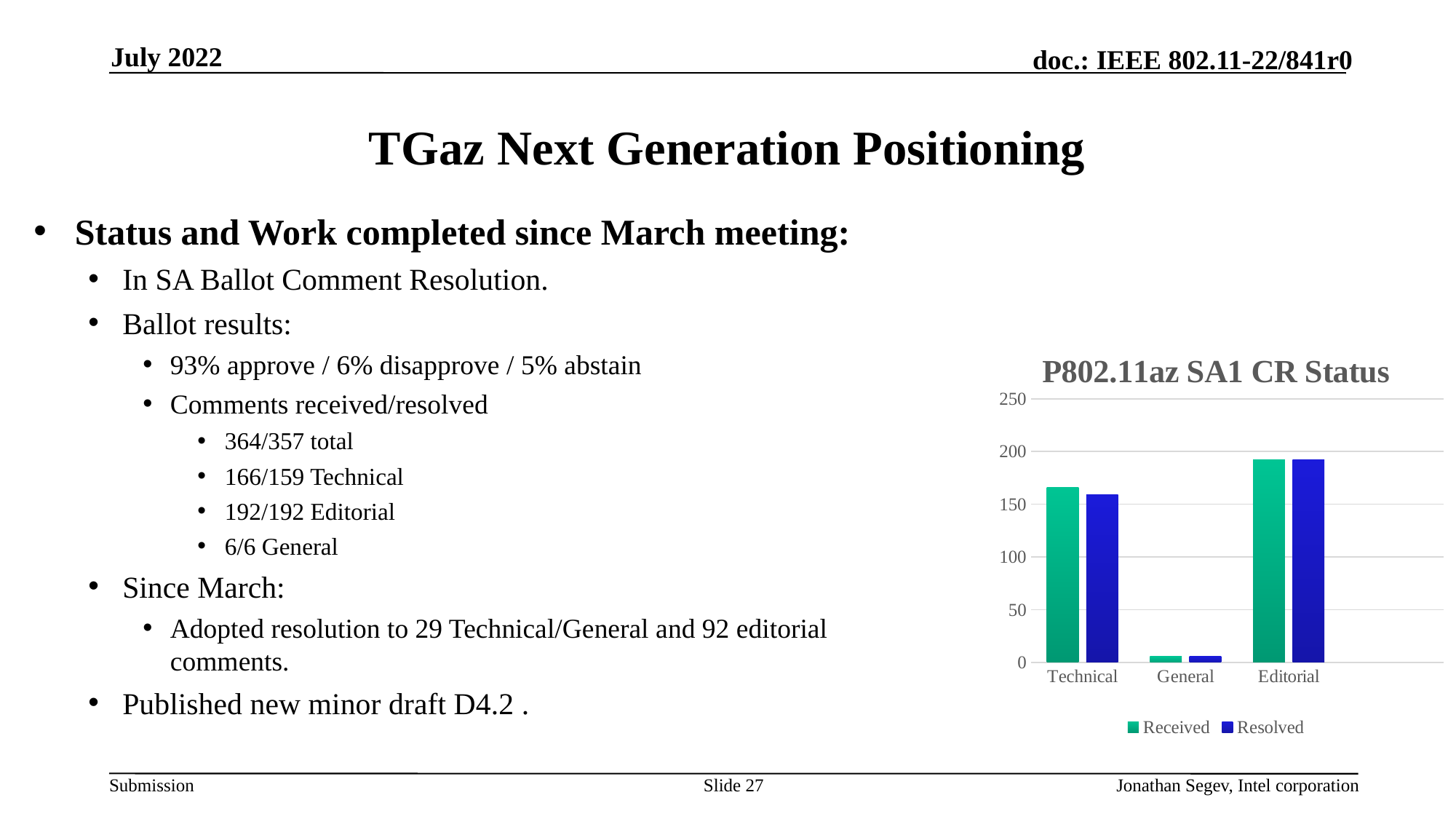
Is the Resolved value for Editorial greater or less than 200? less Is the Received value for General greater or less than 50? less Which category has the highest Received value? Editorial How many series does the chart legend list? 2 Which is larger, the Resolved value for General or the Resolved value for Technical? Technical Which series is shown in blue in the chart? Resolved Which category has the lowest Resolved value? General What type of chart is shown on the slide? bar chart How many categories are shown on the x axis of the chart? 3 Which is larger, the Received value for Editorial or the Received value for Technical? Editorial Is the Received value for Technical greater or less than 150? greater What is the title of the chart? P802.11az SA1 CR Status